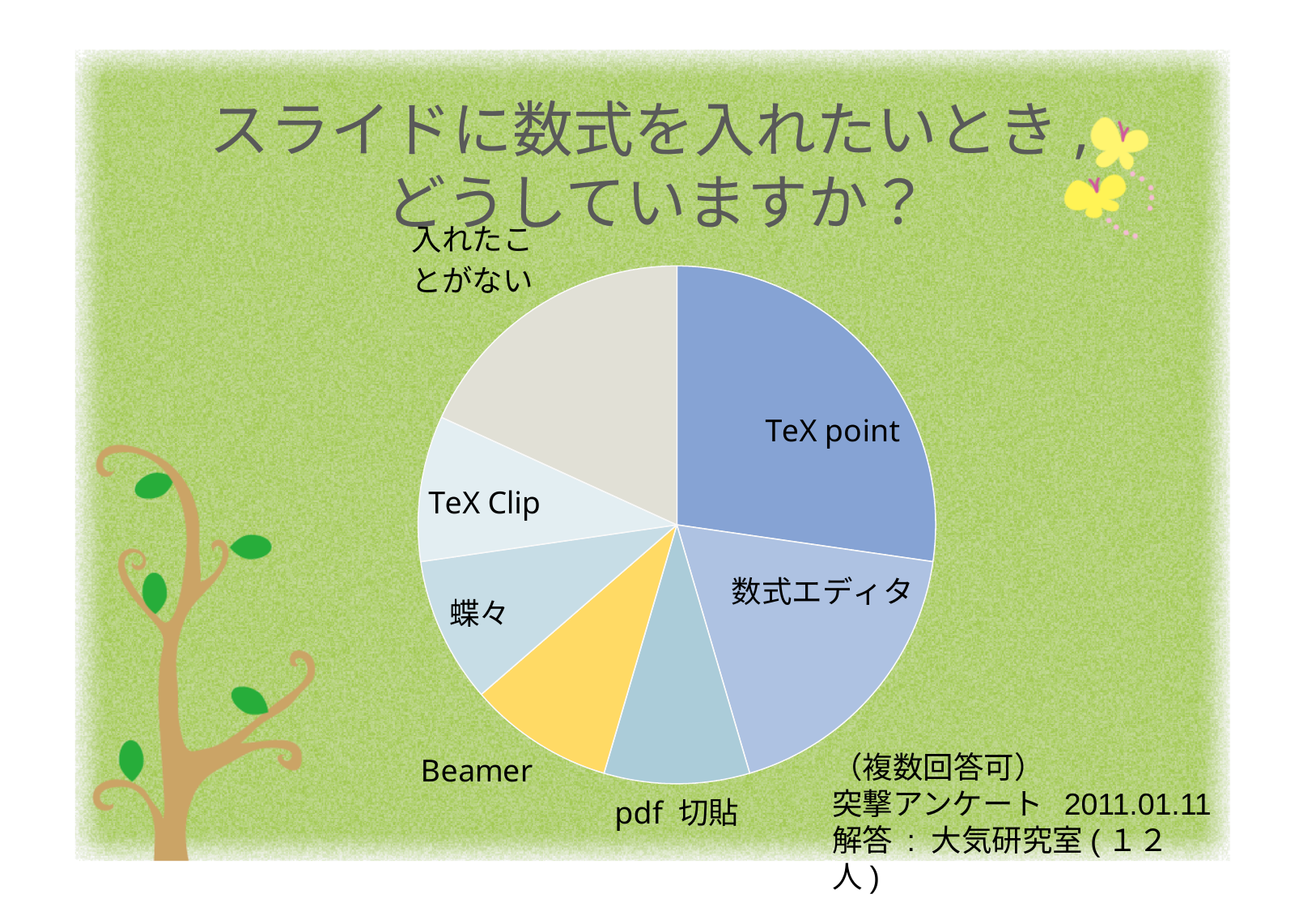
Which slice is larger, 数式エディタ or 蝶々? 数式エディタ What colour is the Beamer slice of the pie chart? yellow Which slice is larger, TeX point or Beamer? TeX point What is the title of the slide containing the pie chart? スライドに数式を入れたいとき, どうしていますか？ How many slices does the pie chart have? 7 Which slice of the pie chart is the largest? TeX point Which slice is larger, TeX Clip or Beamer? Neither; they are the same size What kind of chart is shown on the slide? pie chart